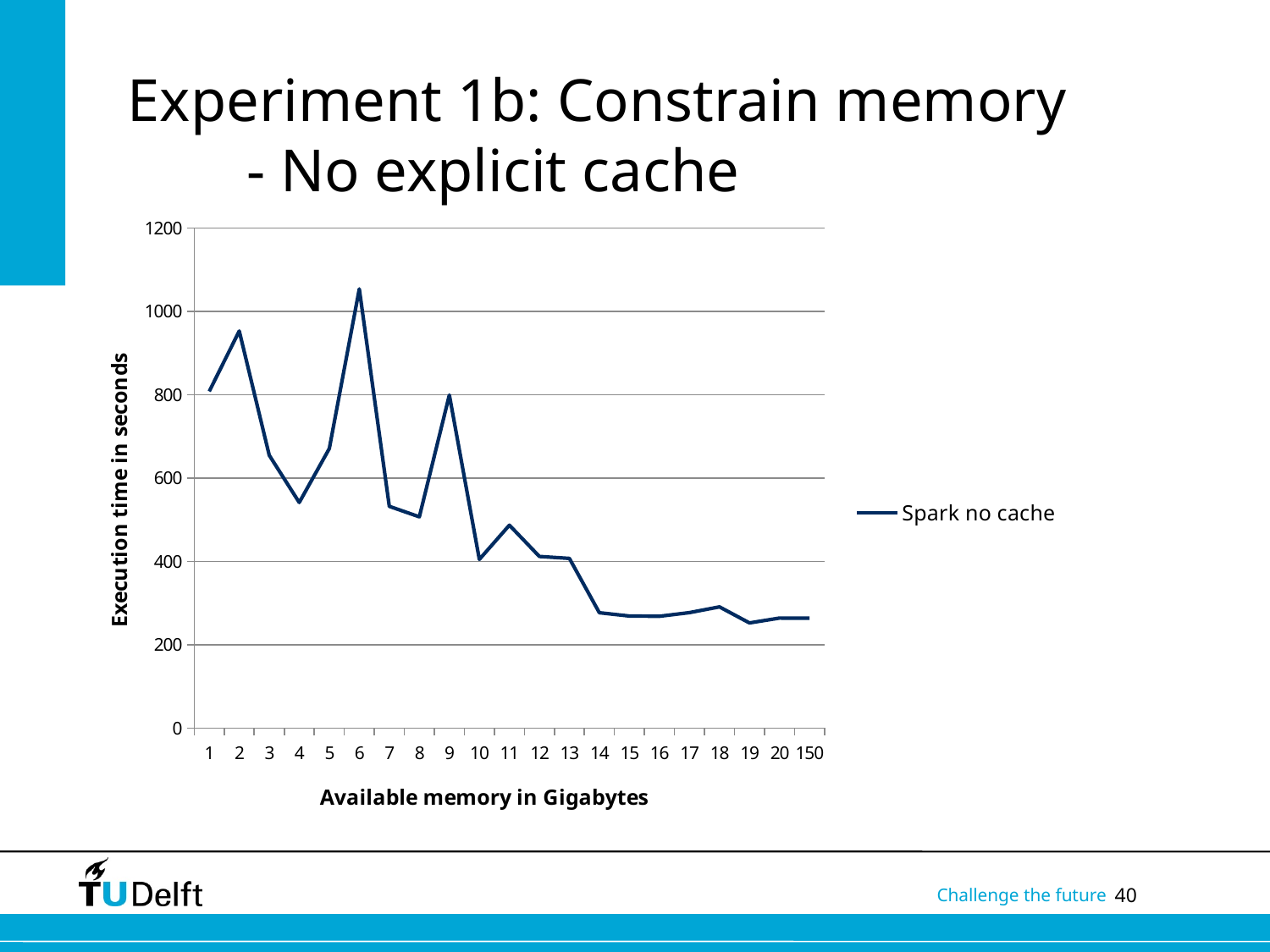
Is the execution time at 6 gigabytes greater or less than 1000 seconds? greater Is the execution time at 4 gigabytes greater or less than 600 seconds? less Is the execution time at 14 gigabytes greater or less than 400 seconds? less Which has the higher execution time, 6 gigabytes or 9 gigabytes? 6 gigabytes Overall, does the execution time rise or fall as available memory increases along the x axis? fall How many series does the legend list? 1 At which available memory value is the execution time highest? 6 What kind of chart is shown on the slide? line chart What is the name of the series shown in the legend? Spark no cache How many data points are plotted along the x axis? 21